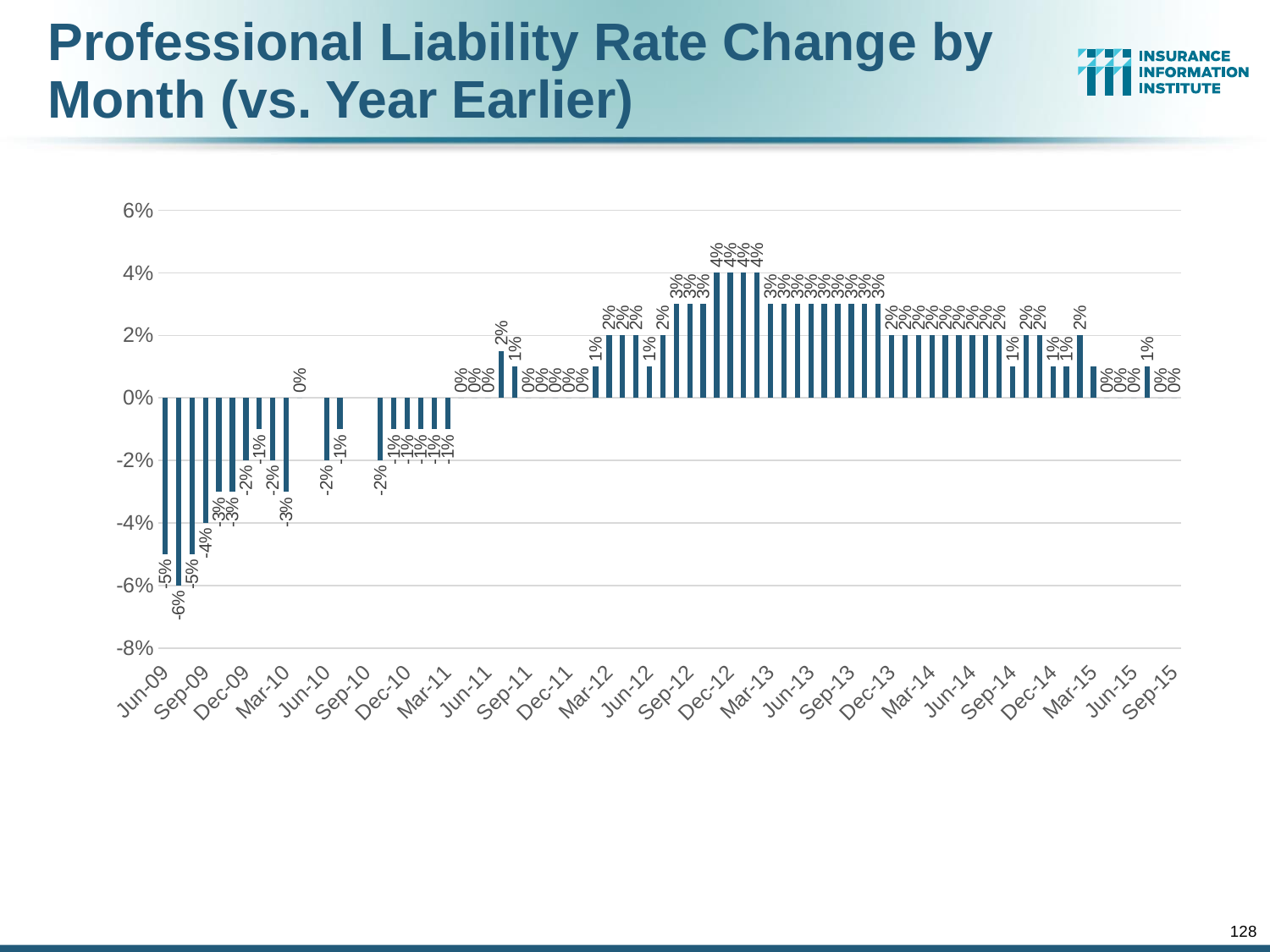
What is the highest rate change value shown in the chart? 4% How many month labels are shown on the x axis? 26 What is the rate change for Jun-09, the first month in the chart? -5% In which year does the rate change first reach 4%? 2012 Do the rate changes generally rise or fall from mid-2009 to late 2012? rise Is the value for Jun-09 greater or less than -4%? less Which has the larger rate change, Jun-09 or Sep-15? Sep-15 What is the rate change for Sep-15, the last month in the chart? 0% What is the difference between the highest value (4%) and the lowest value (-6%) in the chart? 10 percentage points What is the lowest rate change value shown in the chart? -6% What type of chart is shown on the slide? bar chart What is the title of the chart? Professional Liability Rate Change by Month (vs. Year Earlier)